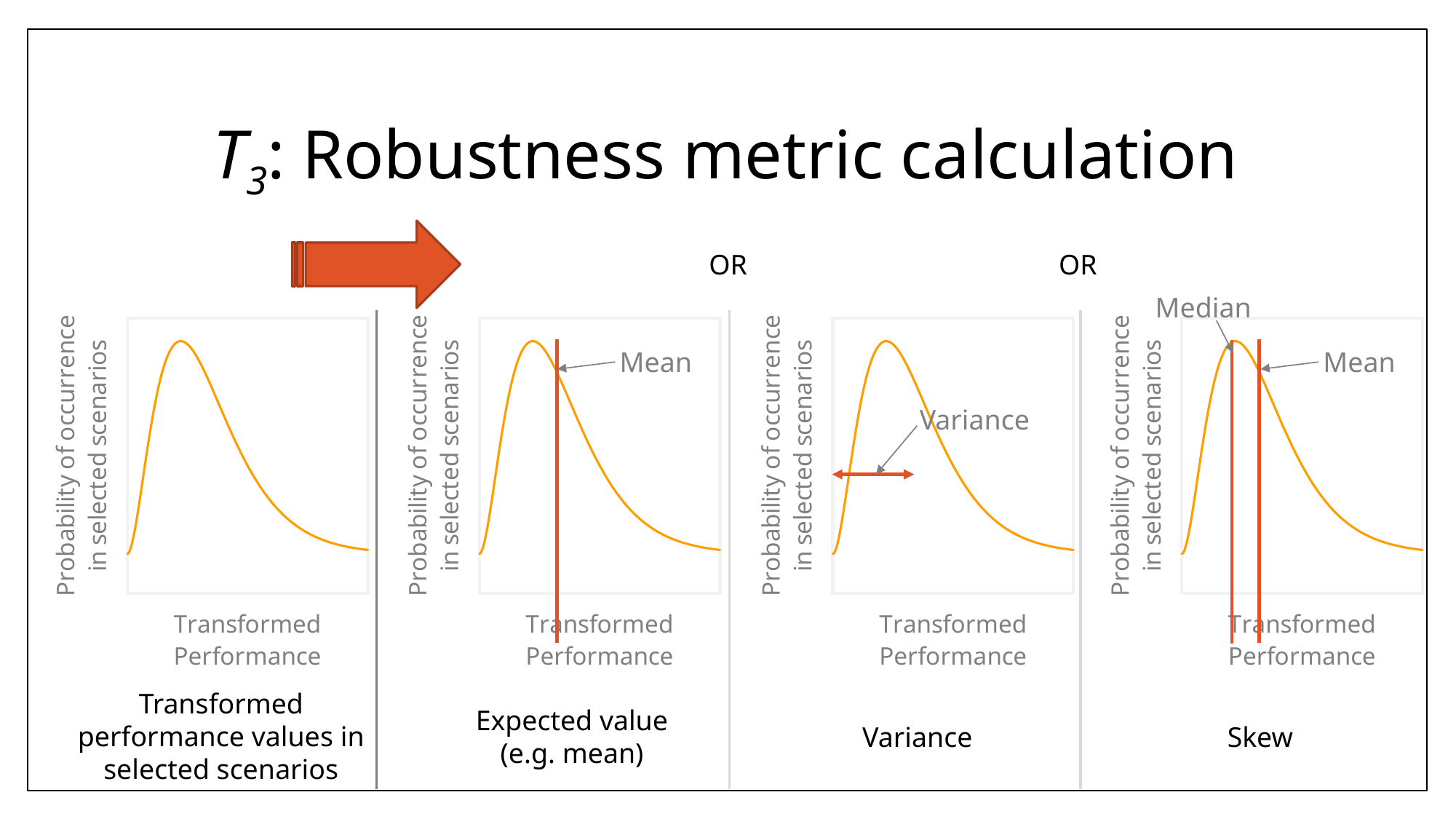
What is the x-axis label on the 'Expected value (e.g. mean)' chart? Transformed Performance What kind of chart is shown in the leftmost panel, 'Transformed performance values in selected scenarios'? line chart What is the y-axis label on the 'Variance' chart? Probability of occurrence in selected scenarios How many charts are shown on the slide? 4 In the 'Variance' chart, does the curve rise or fall along the x axis to the right of its peak? fall In the 'Skew' chart, which vertical line lies further to the right, the Median or the Mean? Mean